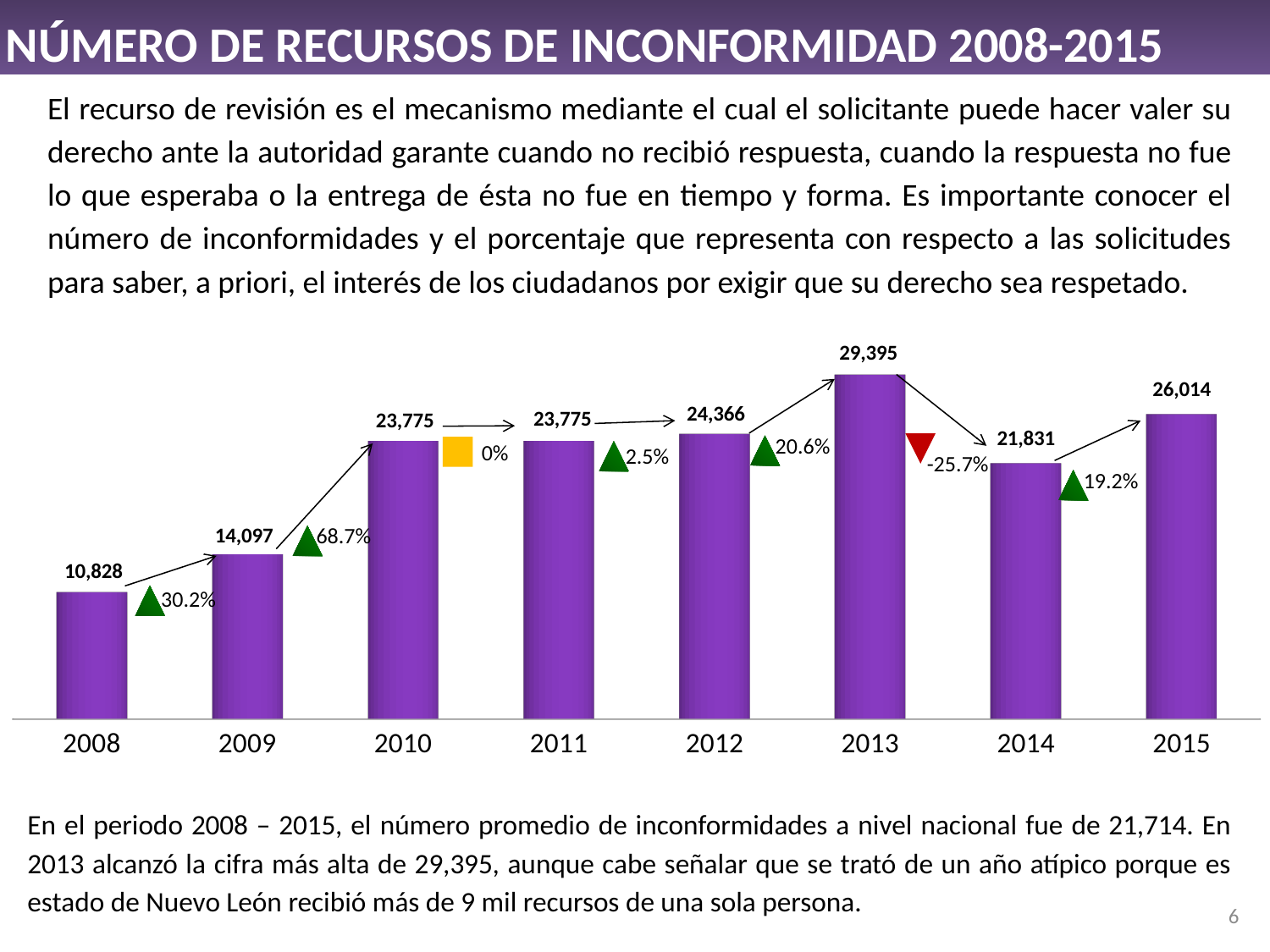
What is the difference between the values for 2013 and 2014? 7,564 What kind of chart is this? bar chart Which year has the lowest value? 2008 Which is larger, the value for 2012 or the value for 2014? 2012 Which year has the highest value? 2013 What percentage change is shown between 2010 and 2011? 0% Do the values rise or fall from 2008 to 2013? rise How many years are shown on the x axis? 8 What is the value for 2015? 26,014 What is the value for 2013? 29,395 What is the value for 2008? 10,828 What is the difference between the values for 2009 and 2008? 3,269